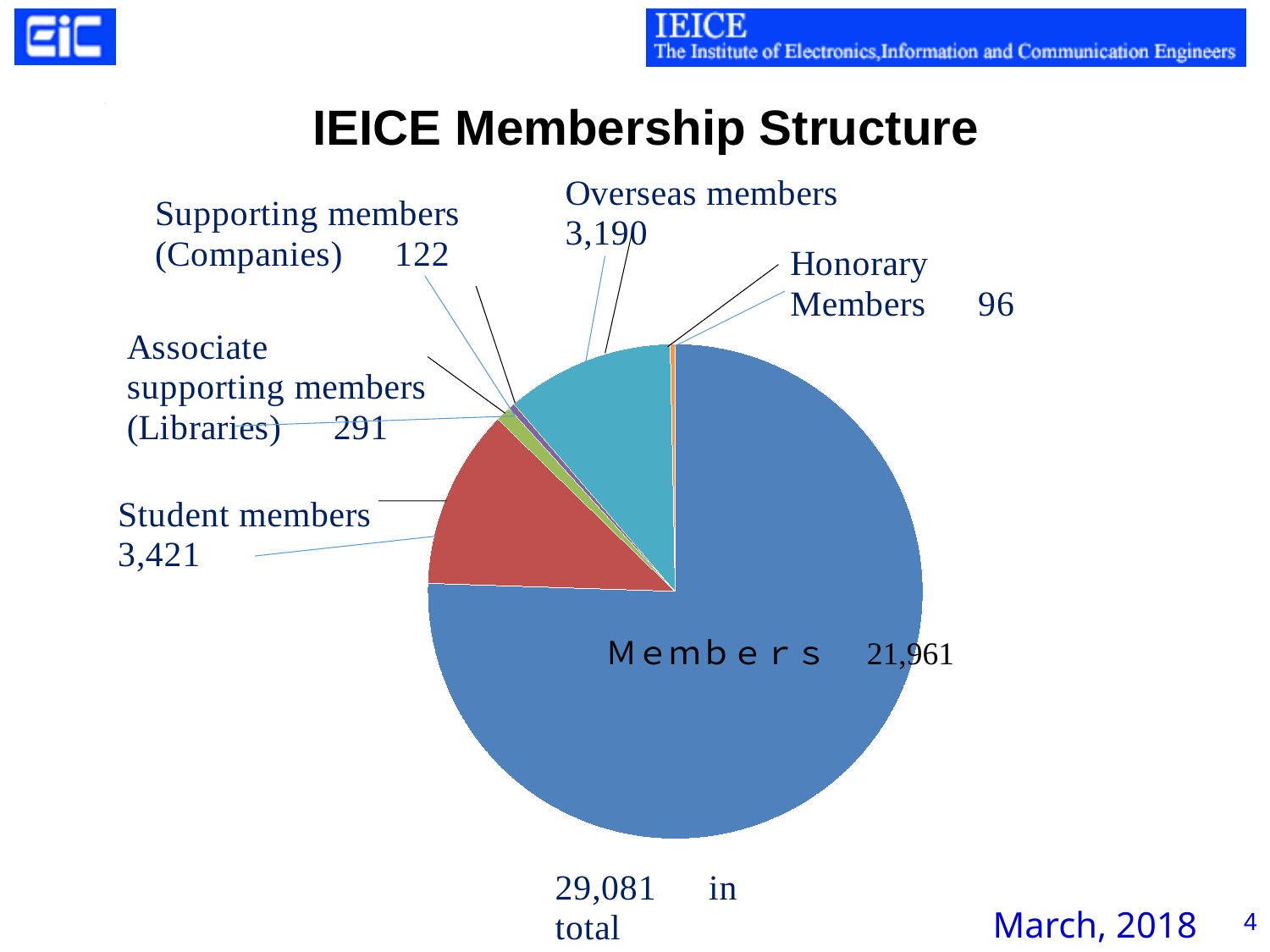
How many Honorary Members are shown on the chart? 96 How many members are in the "Members" category of the pie chart? 21,961 What is the number of Overseas members shown on the chart? 3,190 Which is larger, the number of Student members or the number of Overseas members? Student members What is the difference between the number of Student members and Overseas members? 231 How many membership categories are shown in the pie chart? 6 How many Student members does the pie chart show? 3,421 What is the total membership shown on the slide? 29,081 Which category has the smallest value in the pie chart? Honorary Members Which category has the largest slice of the pie chart? Members What type of chart is used to show the IEICE Membership Structure? Pie chart What is the difference between Associate supporting members (Libraries) and Supporting members (Companies)? 169